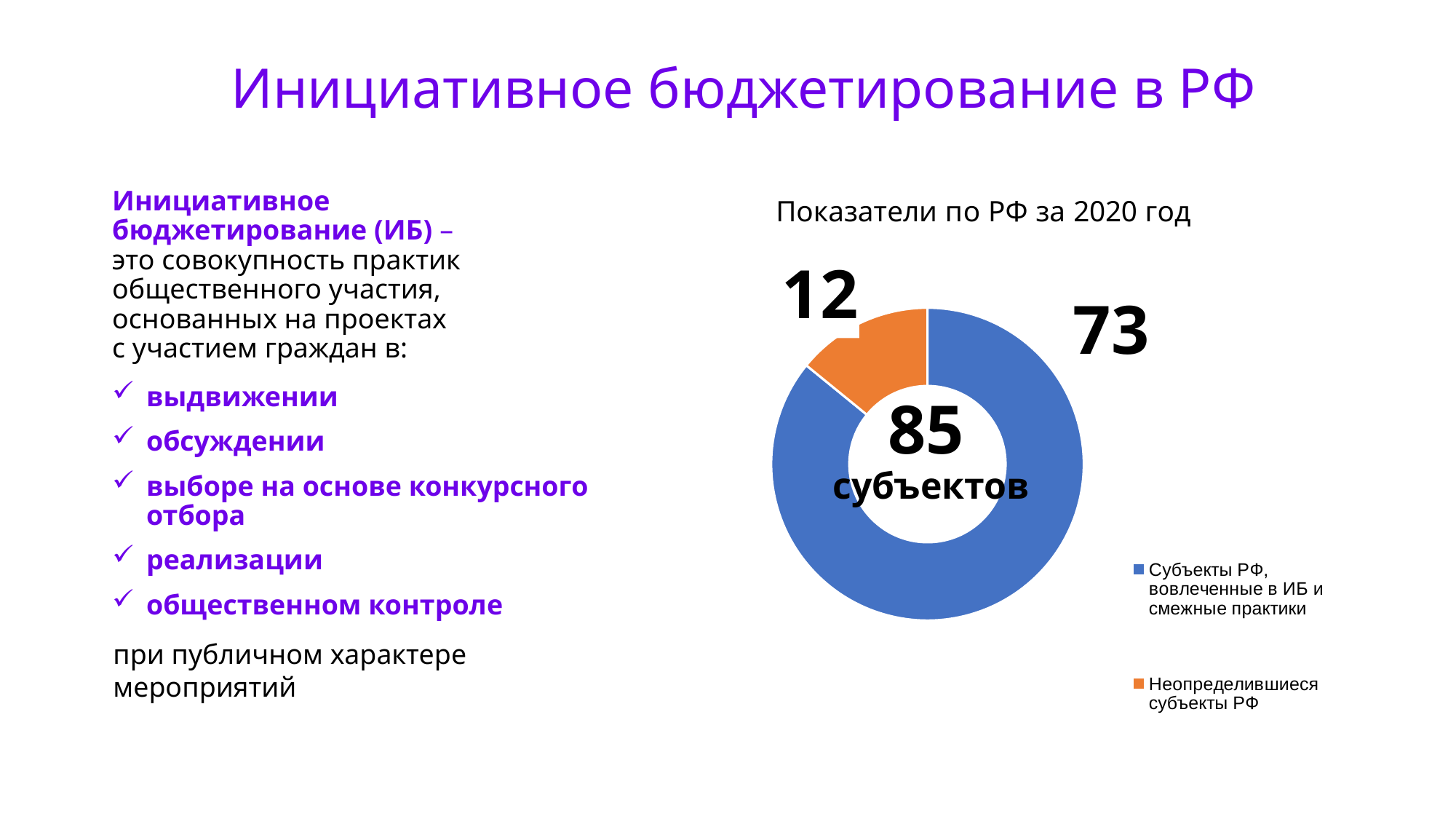
What is the total number of subjects shown in the centre of the chart? 85 субъектов What is the difference between the values for 'Субъекты РФ, вовлеченные в ИБ и смежные практики' and 'Неопределившиеся субъекты РФ'? 61 What kind of chart is shown on the slide? Doughnut (pie) chart What is the value for 'Субъекты РФ, вовлеченные в ИБ и смежные практики' in the chart? 73 What colour is the slice for 'Неопределившиеся субъекты РФ'? Orange What is the title of the chart? Показатели по РФ за 2020 год Which category has the largest value in the chart? Субъекты РФ, вовлеченные в ИБ и смежные практики What is the value for 'Неопределившиеся субъекты РФ' in the chart? 12 How many entries does the chart legend list? 2 Which category has the smallest value in the chart? Неопределившиеся субъекты РФ Which is larger: the value for 'Субъекты РФ, вовлеченные в ИБ и смежные практики' or for 'Неопределившиеся субъекты РФ'? Субъекты РФ, вовлеченные в ИБ и смежные практики How many categories are shown in the chart? 2